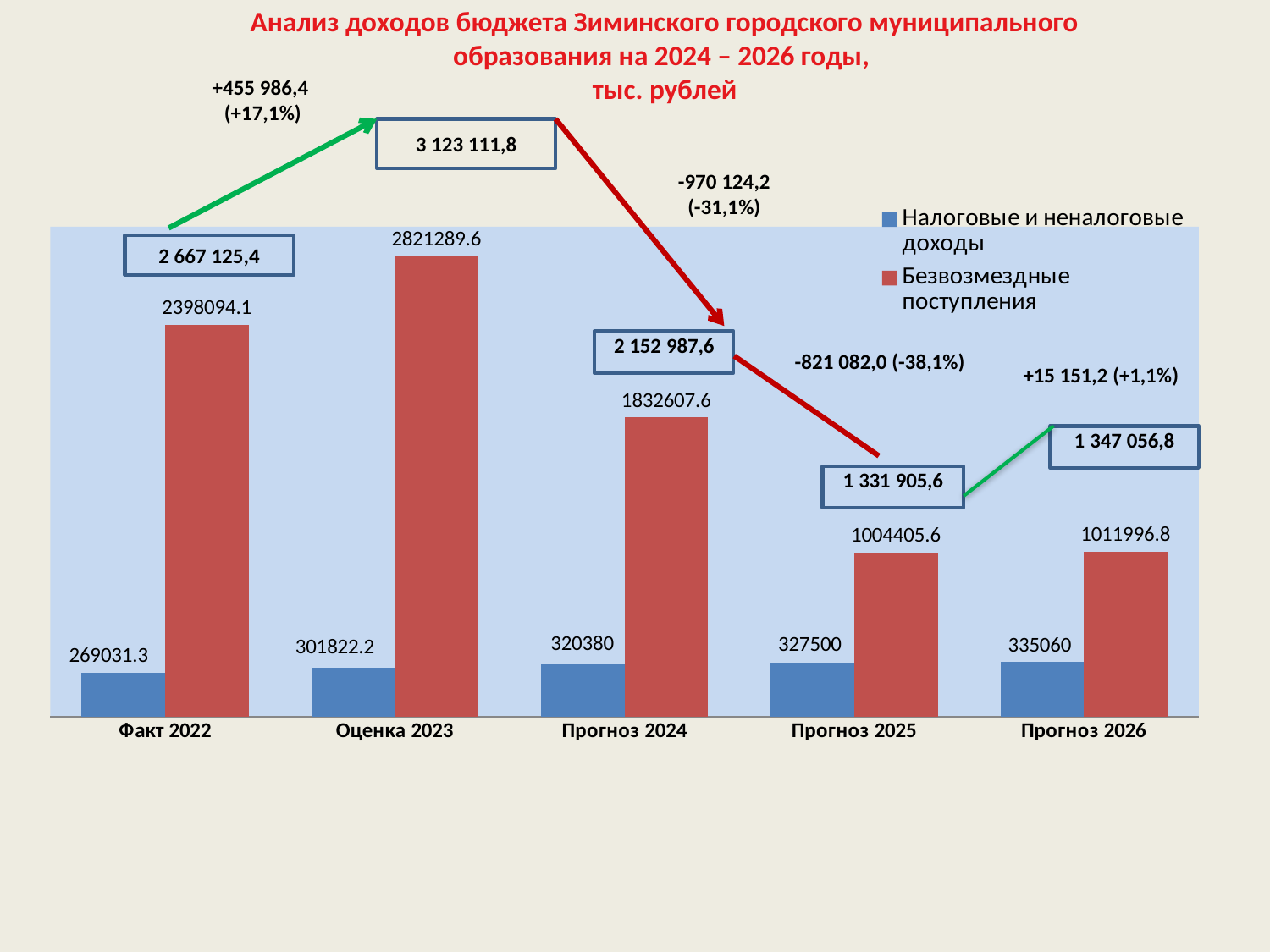
Which is larger: Безвозмездные поступления for Факт 2022 or for Прогноз 2024? Факт 2022 What total is shown in the box above the Прогноз 2024 bars? 2 152 987,6 How many categories are shown on the x axis? 5 What is the value of Налоговые и неналоговые доходы for Прогноз 2024? 320380 Do the values of Налоговые и неналоговые доходы rise or fall from Факт 2022 to Прогноз 2026? rise What is the value of Безвозмездные поступления for Прогноз 2025? 1004405.6 What is the difference between Налоговые и неналоговые доходы for Прогноз 2026 and Прогноз 2025? 7560 What type of chart is shown on the slide? bar chart What is the value of Безвозмездные поступления for Оценка 2023? 2821289.6 Which category has the highest value for Безвозмездные поступления? Оценка 2023 How many series does the legend list? 2 Which category has the lowest value for Налоговые и неналоговые доходы? Факт 2022